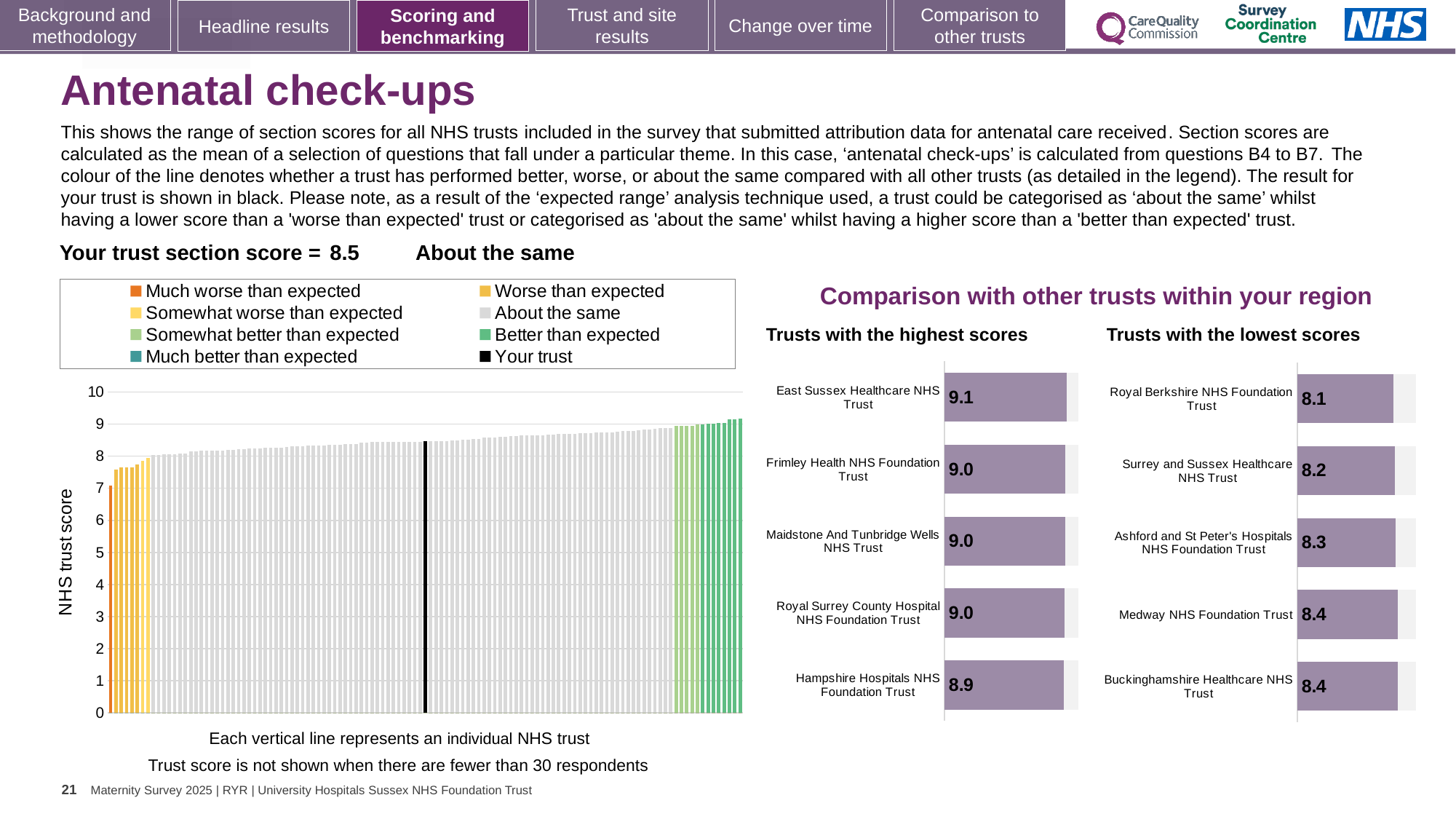
In the 'NHS trust score' chart, do the bar values rise or fall from left to right? Rise How many entries does the legend above the 'NHS trust score' chart list? 8 What kind of chart is the 'NHS trust score' chart on the left of the slide? Bar chart In the 'Trusts with the lowest scores' chart, what is the difference between the scores of Medway NHS Foundation Trust and Royal Berkshire NHS Foundation Trust? 0.3 In the 'Trusts with the highest scores' chart, what is the difference between the scores of East Sussex Healthcare NHS Trust and Hampshire Hospitals NHS Foundation Trust? 0.2 How many trusts are shown in the 'Trusts with the highest scores' chart? 5 In the 'Trusts with the lowest scores' chart, which trust has the lowest score? Royal Berkshire NHS Foundation Trust In the 'Trusts with the highest scores' chart, what is the score for East Sussex Healthcare NHS Trust? 9.1 In the 'Trusts with the highest scores' chart, which trust has the highest score? East Sussex Healthcare NHS Trust What is the section score for your trust shown on the slide? 8.5 In the 'Trusts with the lowest scores' chart, which has the higher score: Ashford and St Peter's Hospitals NHS Foundation Trust or Surrey and Sussex Healthcare NHS Trust? Ashford and St Peter's Hospitals NHS Foundation Trust In the 'Trusts with the lowest scores' chart, what is the score for Royal Berkshire NHS Foundation Trust? 8.1